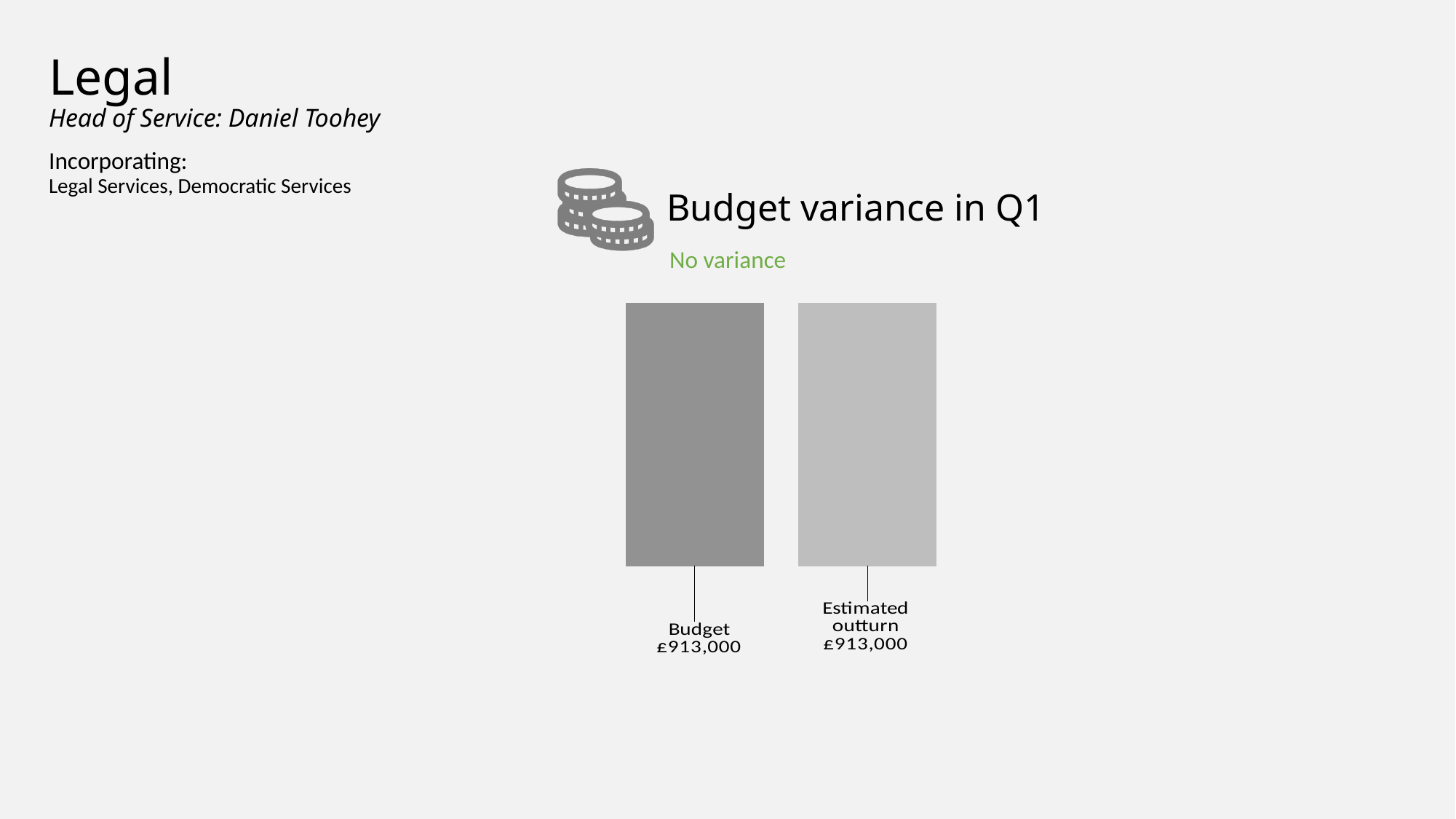
What is the value of the Estimated outturn bar? £913,000 What is the difference between the Budget and the Estimated outturn? £0 Are the Budget and Estimated outturn values equal? Yes What is the value of the Budget bar? £913,000 What does the green text under the chart title say about the variance? No variance How many bars are shown in the chart? 2 What is the title of the chart? Budget variance in Q1 What are the two categories labelled on the chart? Budget, Estimated outturn What kind of chart is shown on the slide? Bar chart